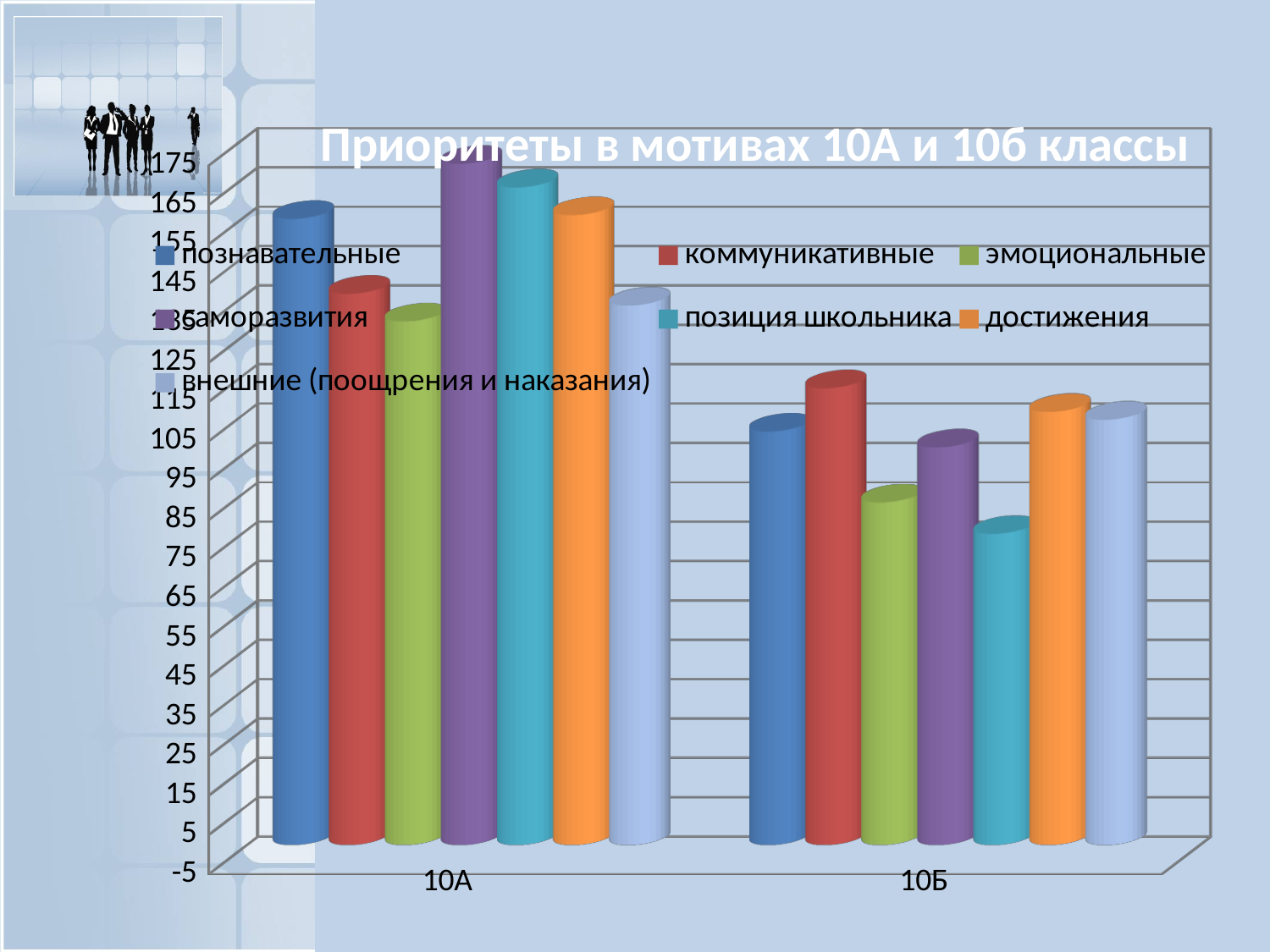
Is the value for позиция школьника in class 10Б greater or less than 95? less Which series has the highest value for class 10А? саморазвития What kind of chart is shown on the slide? bar chart Is the value for познавательные in class 10А greater or less than 145? greater How many categories (classes) are shown on the x axis? 2 Is the value for саморазвития in class 10А greater or less than 155? greater Which series has the lowest value for class 10А? эмоциональные What is the title of the chart? Приоритеты в мотивах 10А и 10б классы Which series has the lowest value for class 10Б? позиция школьника How many series does the legend list? 7 Which class has the larger value for познавательные, 10А or 10Б? 10А